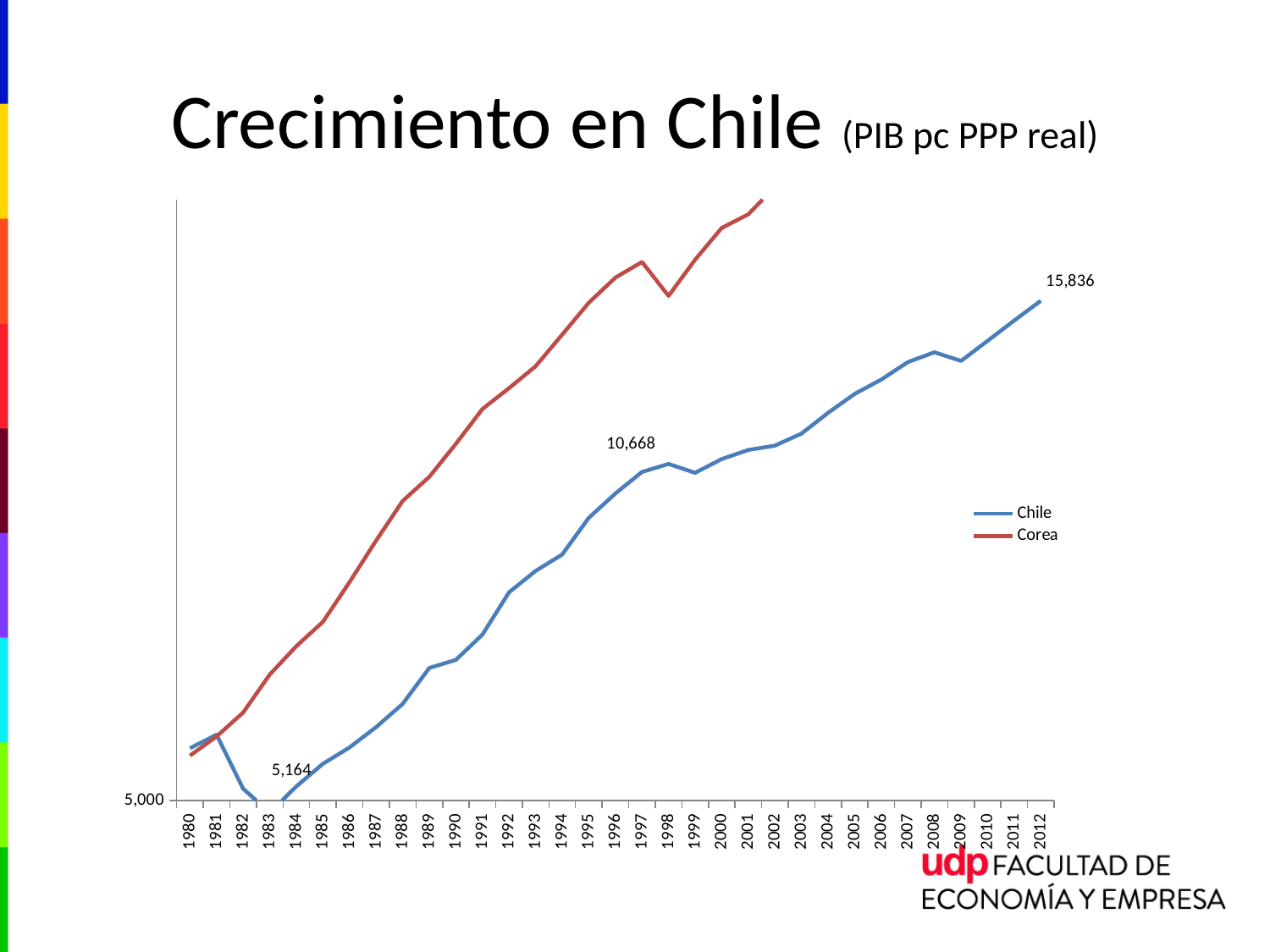
Which series are listed in the legend? Chile and Corea What value is labelled on the Chile line for 1997? 10,668 How many series does the legend list? 2 What is the lowest value labelled on the Chile line? 5,164 What kind of chart is shown on the slide? line chart What is the difference between the Chile values labelled for 2012 and 1997? 5,168 In 1995, which series has the higher value, Chile or Corea? Corea How many years are shown on the x axis? 33 What colour is the Chile line? blue Does the Chile line generally rise or fall from 1984 to 2012? rise What value is labelled on the Chile line for 2012? 15,836 What is the difference between the Chile value labelled for 2012 and the lowest labelled Chile value, 5,164? 10,672